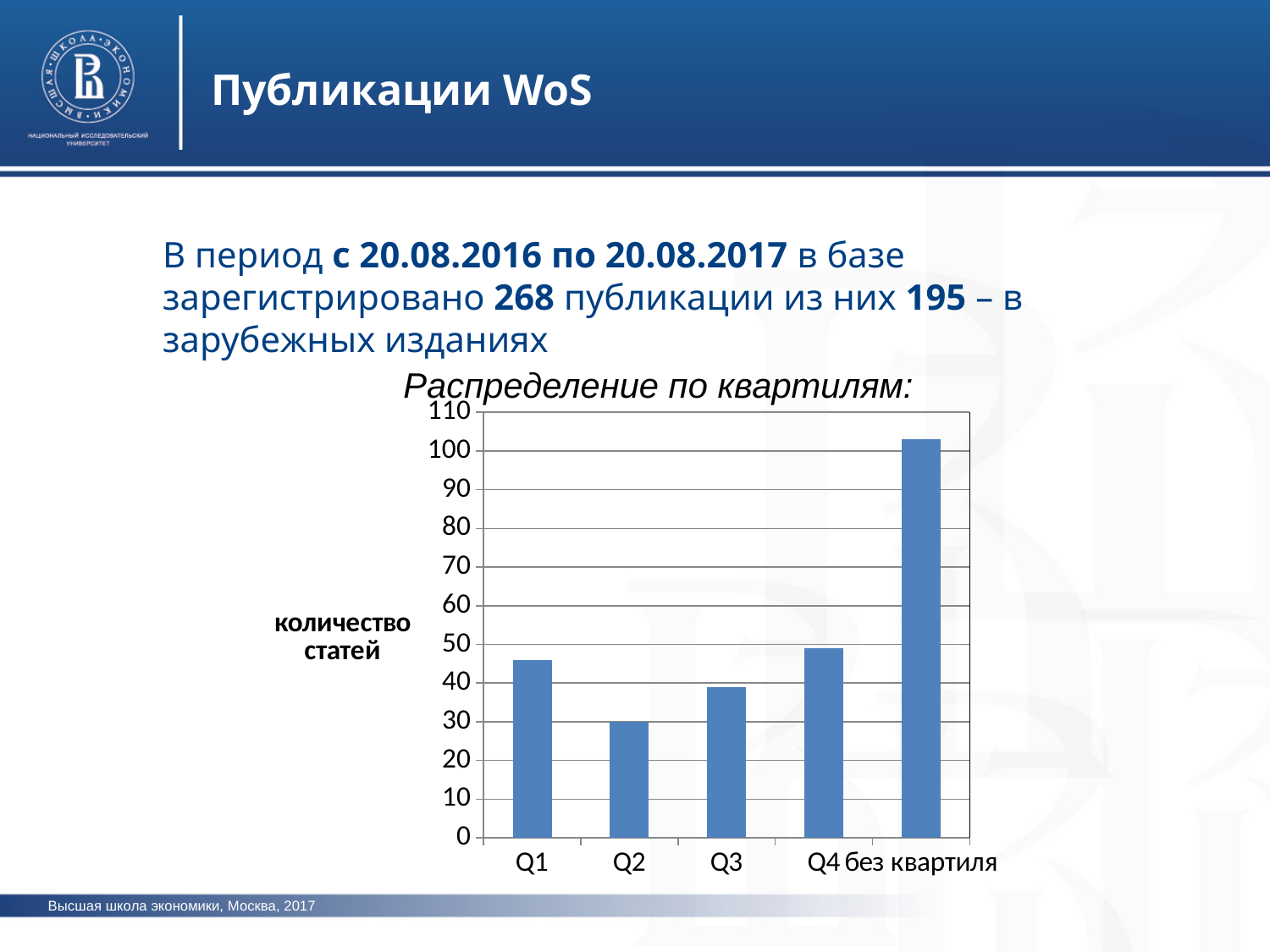
What is the label of the vertical axis of the chart? количество статей What is the title of the chart? Распределение по квартилям: Which has a larger value, Q1 or Q3? Q1 Which category has the highest bar in the chart? без квартиля Which has a larger value, Q2 or Q3? Q3 Is the value for без квартиля greater or less than 100? greater Which category has the lowest bar in the chart? Q2 What kind of chart is shown on the slide? bar chart Is the value for Q2 greater or less than 40? less Is the value for Q1 greater or less than 50? less How many categories are shown on the x axis of the chart? 5